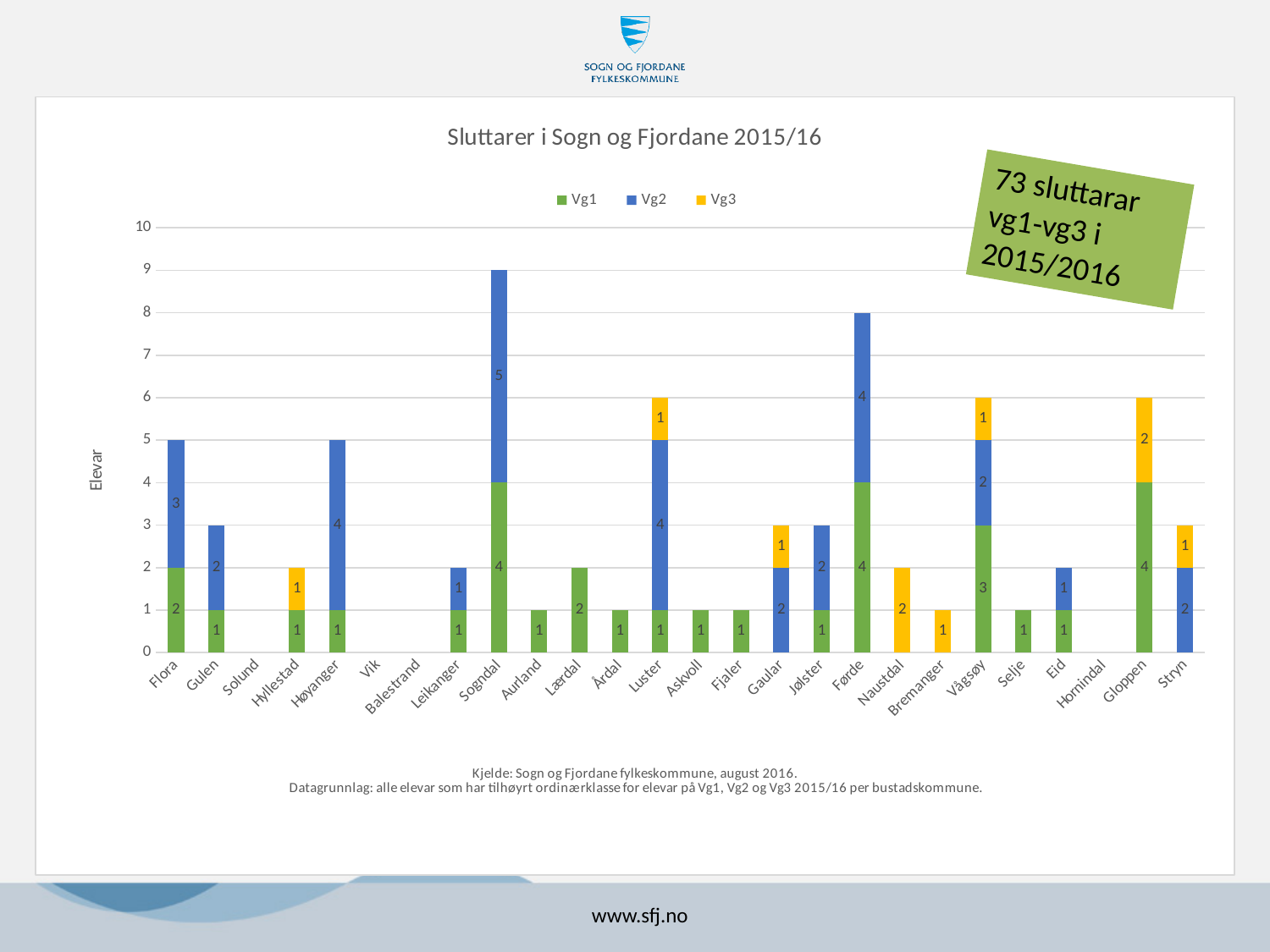
What is the title of the chart? Sluttarer i Sogn og Fjordane 2015/16 What is the total height of the stacked bar for Luster? 6 What is the Vg3 value for Gloppen? 2 What is the difference between the Vg2 value for Høyanger and the Vg2 value for Gulen? 2 How many series does the legend list? 3 Which is larger, the Vg1 value for Sogndal or the Vg1 value for Vågsøy? Sogndal What kind of chart is shown on the slide? Stacked bar chart What is the Vg2 value for Sogndal? 5 What is the Vg3 value for Naustdal? 2 What is the Vg1 value for Førde? 4 Which municipality has the highest total number of sluttarar? Sogndal What is the total height of the stacked bar for Vågsøy? 6